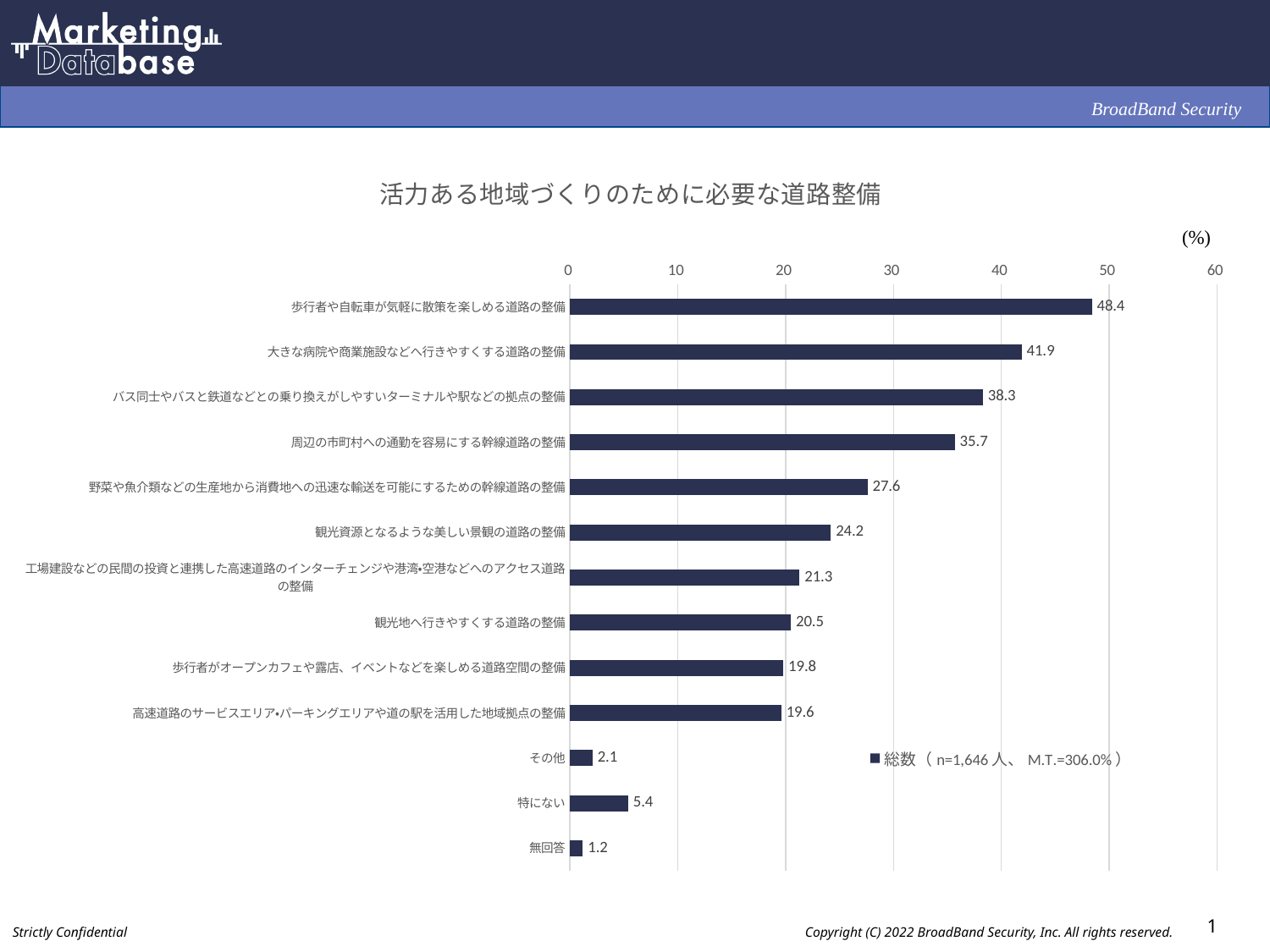
Which category has the highest value? 歩行者や自転車が気軽に散策を楽しめる道路の整備 How many series does the legend list? 1 What is the difference between the values for 大きな病院や商業施設などへ行きやすくする道路の整備 and バス同士やバスと鉄道などとの乗り換えがしやすいターミナルや駅などの拠点の整備? 3.6 What kind of chart is shown on the slide? bar chart Which is larger, the value for 観光資源となるような美しい景観の道路の整備 or the value for 観光地へ行きやすくする道路の整備? 観光資源となるような美しい景観の道路の整備 Which category has the lowest value? 無回答 Is the value for 野菜や魚介類などの生産地から消費地への迅速な輸送を可能にするための幹線道路の整備 greater or less than 30? less How many categories are shown in the chart? 13 What is the title of the chart? 活力ある地域づくりのために必要な道路整備 What is the value for 周辺の市町村への通勤を容易にする幹線道路の整備? 35.7 What is the value for 特にない? 5.4 What is the value for 歩行者や自転車が気軽に散策を楽しめる道路の整備? 48.4